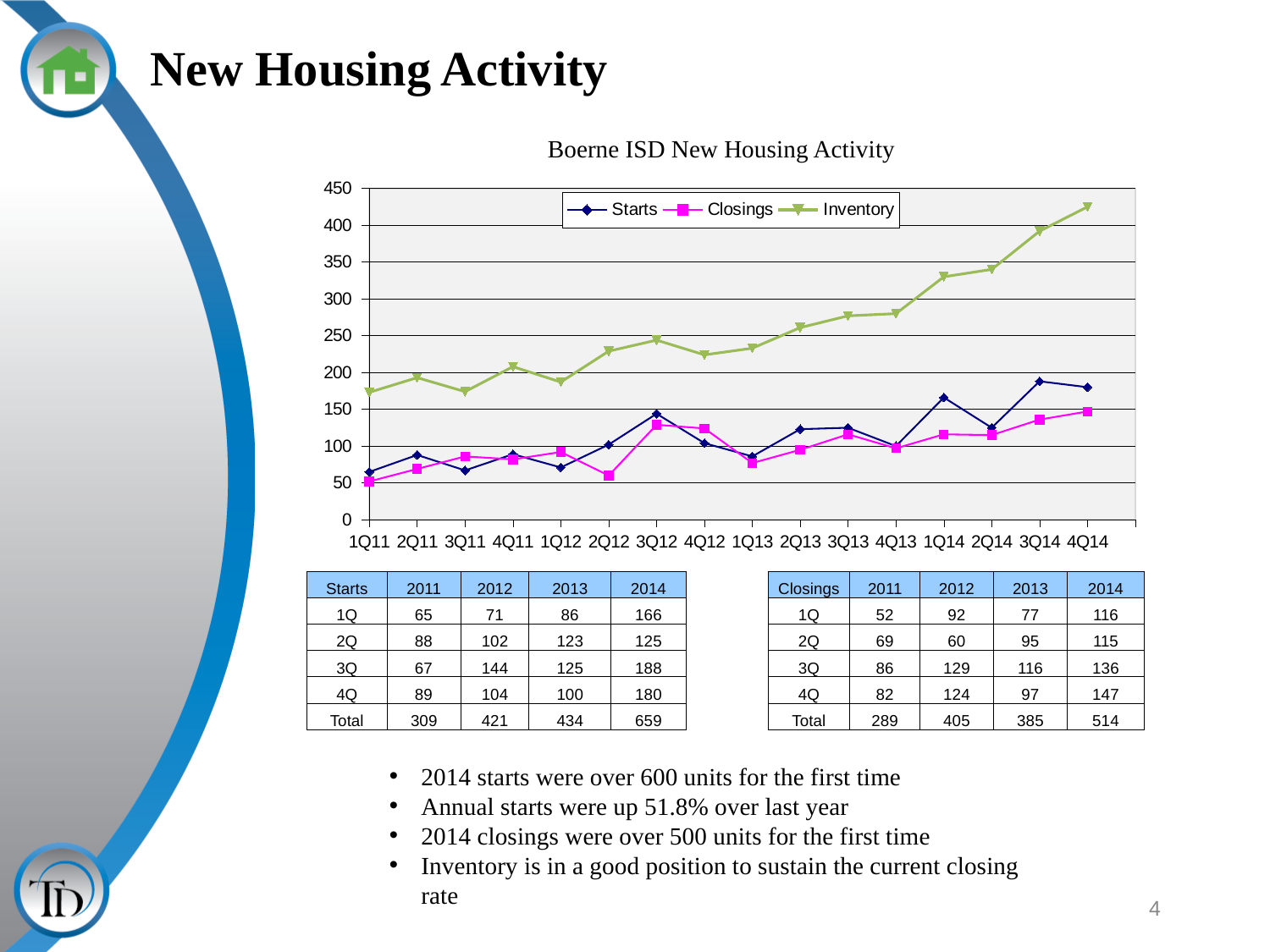
Is the Inventory value for 4Q14 greater or less than 400? greater What are the three series named in the chart legend? Starts, Closings, Inventory How many series does the chart legend list? 3 What is the value of Closings in 4Q14? 147 How many quarters are plotted along the x axis of the chart? 16 What is the value of Starts in 3Q14? 188 Does the Inventory series generally rise or fall from 1Q11 to 4Q14? rise What kind of chart is shown on the slide? line chart In 3Q12, which is larger, Starts or Closings? Starts What is the difference between Starts and Closings in 1Q14? 50 In which quarter is the Starts series at its highest? 3Q14 In which quarter is the Closings series at its lowest? 1Q11